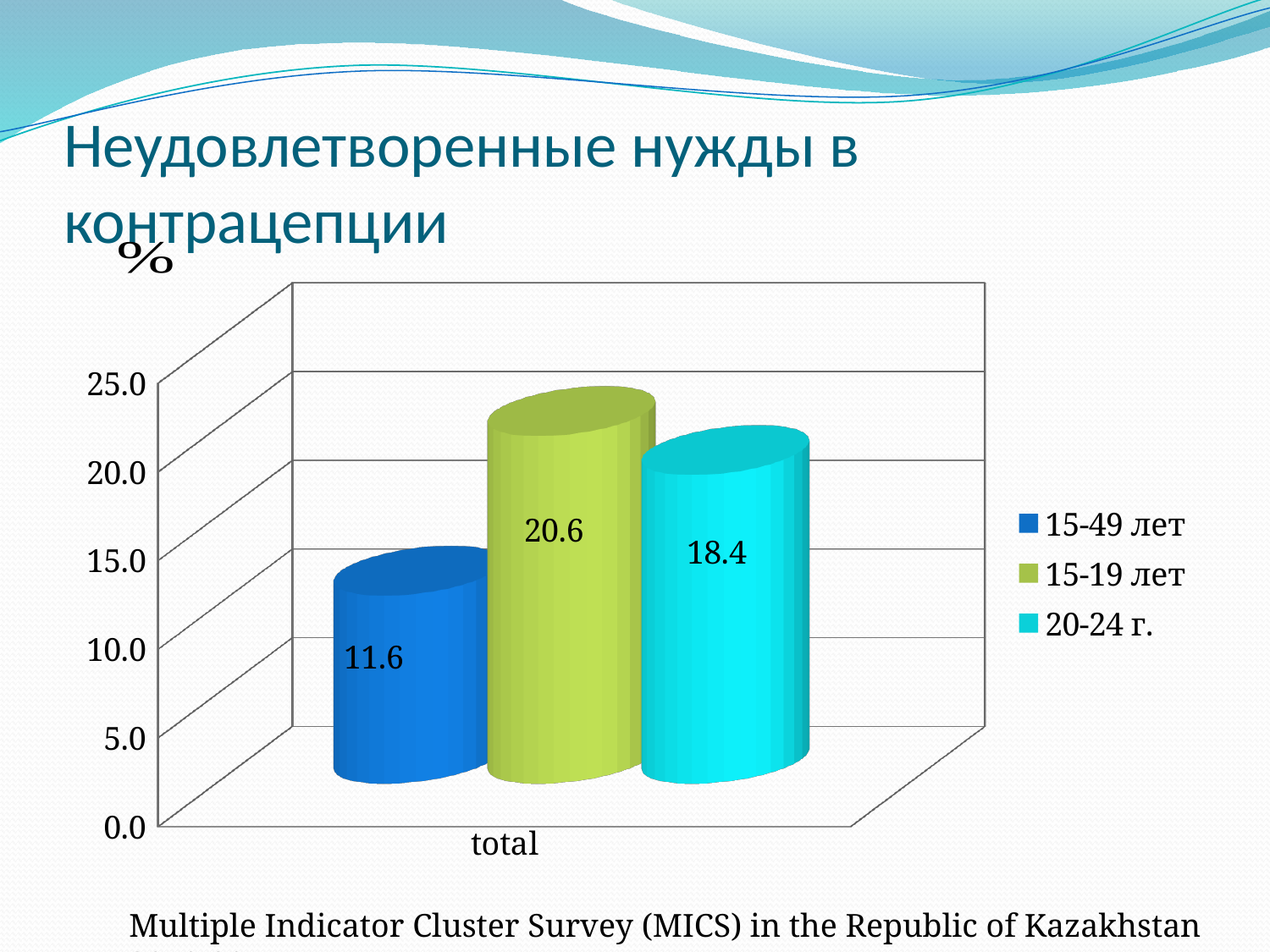
What is the value for the 15-49 лет series? 11.6 What is the value for the 15-19 лет series? 20.6 What is the value for the 20-24 г. series? 18.4 Which is larger, the value for 20-24 г. or the value for 15-49 лет? 20-24 г. Is the value for 15-49 лет greater or less than 15.0? less What is the label of the category on the x axis? total What kind of chart is shown on the slide? bar chart What is the difference between the values for 15-19 лет and 15-49 лет? 9.0 What is the difference between the values for 15-19 лет and 20-24 г.? 2.2 How many series does the legend list? 3 Which series has the lowest value? 15-49 лет Which series has the highest value? 15-19 лет